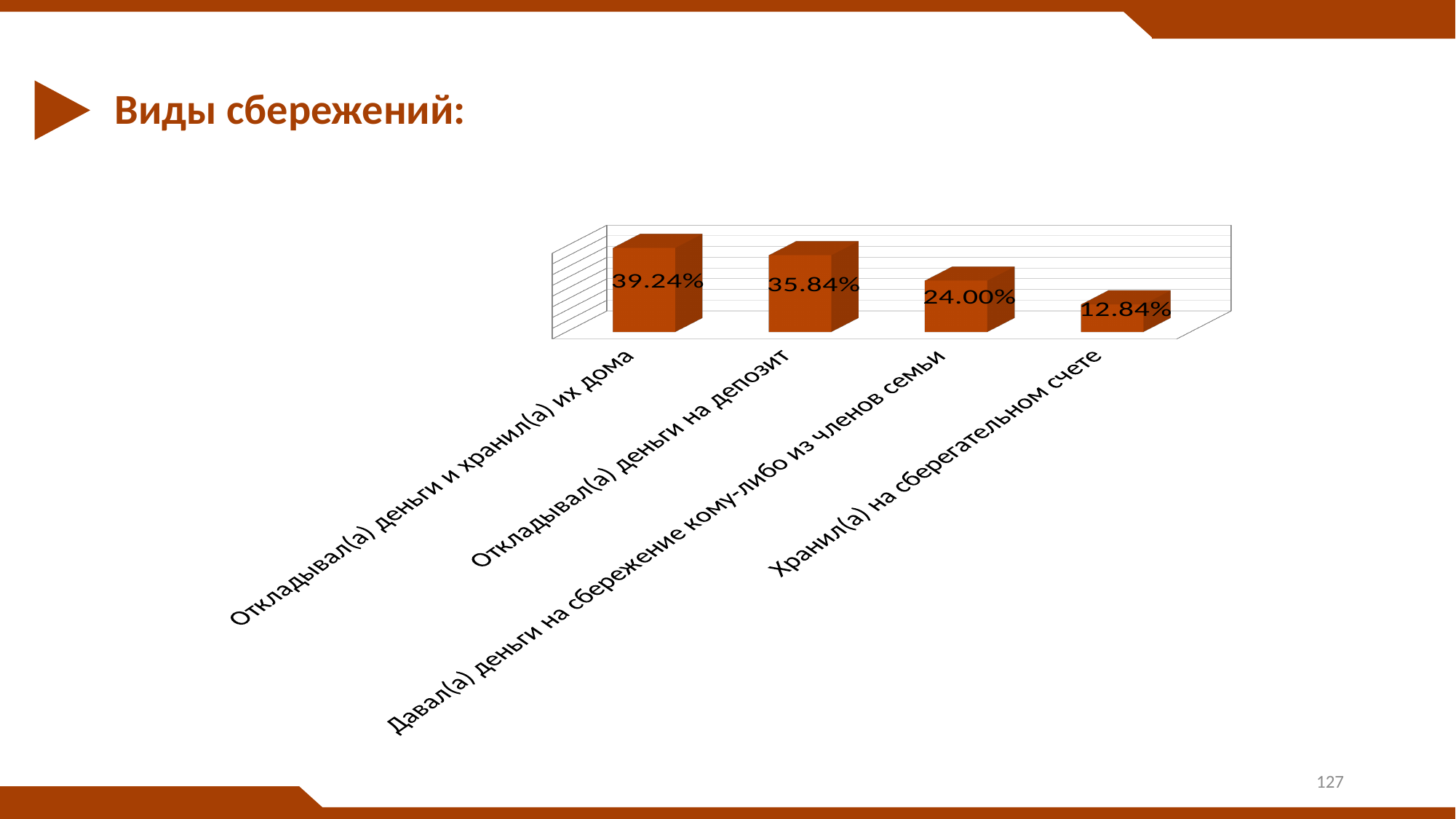
What is the difference between the values for "Давал(а) деньги на сбережение кому-либо из членов семьи" and "Хранил(а) на сберегательном счете"? 11.16% What value is shown for "Откладывал(а) деньги на депозит"? 35.84% Which category has the highest value? Откладывал(а) деньги и хранил(а) их дома What value is shown for "Откладывал(а) деньги и хранил(а) их дома"? 39.24% How many categories are shown in the chart? 4 What is the difference between the values for "Откладывал(а) деньги и хранил(а) их дома" and "Откладывал(а) деньги на депозит"? 3.40% What value is shown for "Давал(а) деньги на сбережение кому-либо из членов семьи"? 24.00% Which category has the lowest value? Хранил(а) на сберегательном счете What value is shown for "Хранил(а) на сберегательном счете"? 12.84% Do the values rise or fall from left to right along the x axis? Fall Which is larger: the value for "Откладывал(а) деньги на депозит" or for "Давал(а) деньги на сбережение кому-либо из членов семьи"? Откладывал(а) деньги на депозит What kind of chart is shown on the slide? Bar chart